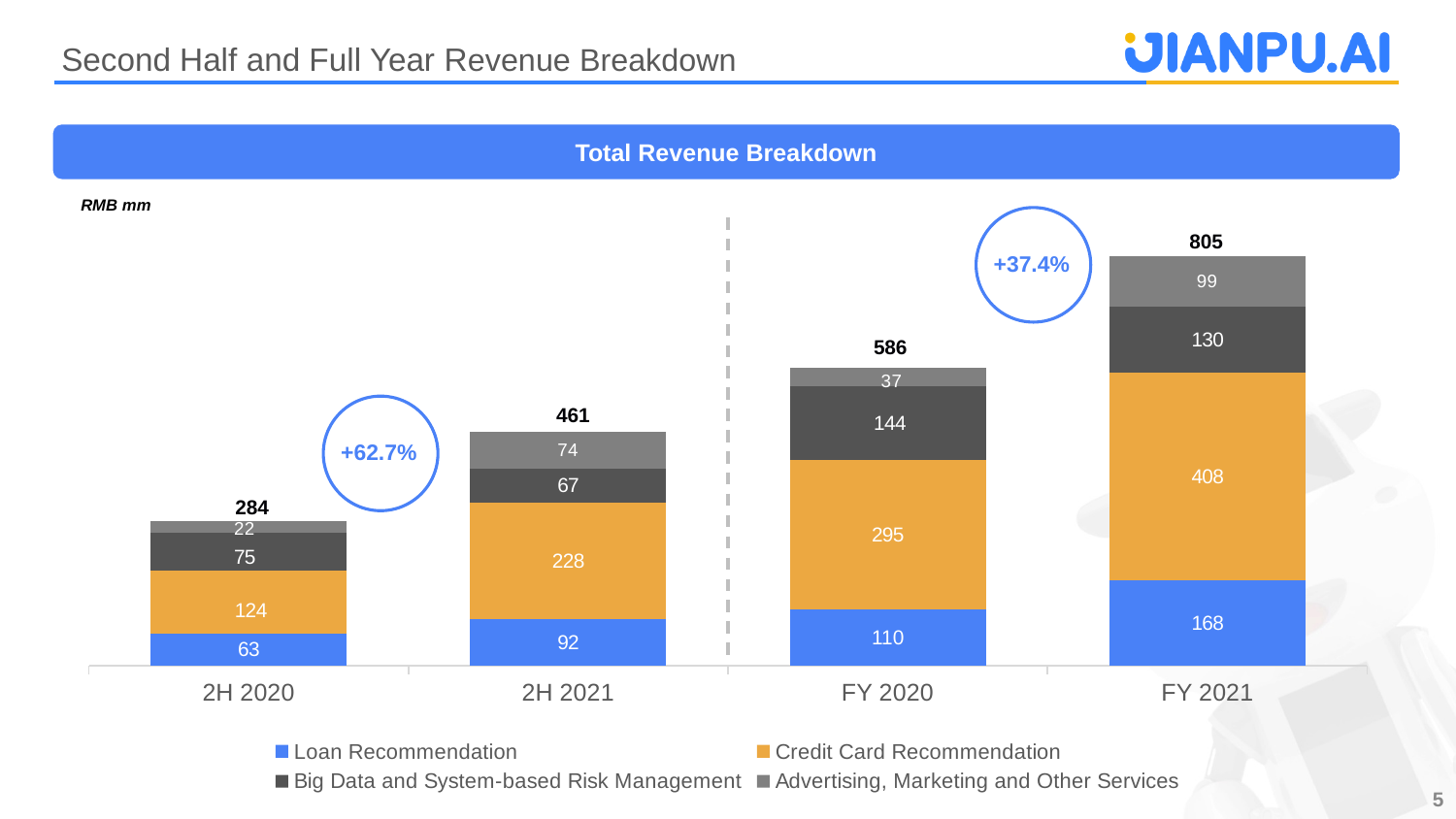
Which is larger: Loan Recommendation revenue in 2H 2021 or in FY 2020? FY 2020 What is the Credit Card Recommendation revenue for FY 2021? 408 What kind of chart is shown? Stacked bar chart How many periods are shown on the x axis? 4 How many series does the legend list? 4 What growth percentage is shown between FY 2020 and FY 2021? +37.4% What is the Loan Recommendation revenue for 2H 2020? 63 What is the difference between the Big Data and System-based Risk Management revenue in FY 2021 and FY 2020? -14 Which period has the lowest total revenue? 2H 2020 What is the total revenue shown for 2H 2021? 461 What is the Advertising, Marketing and Other Services revenue for FY 2020? 37 Which period has the highest total revenue? FY 2021